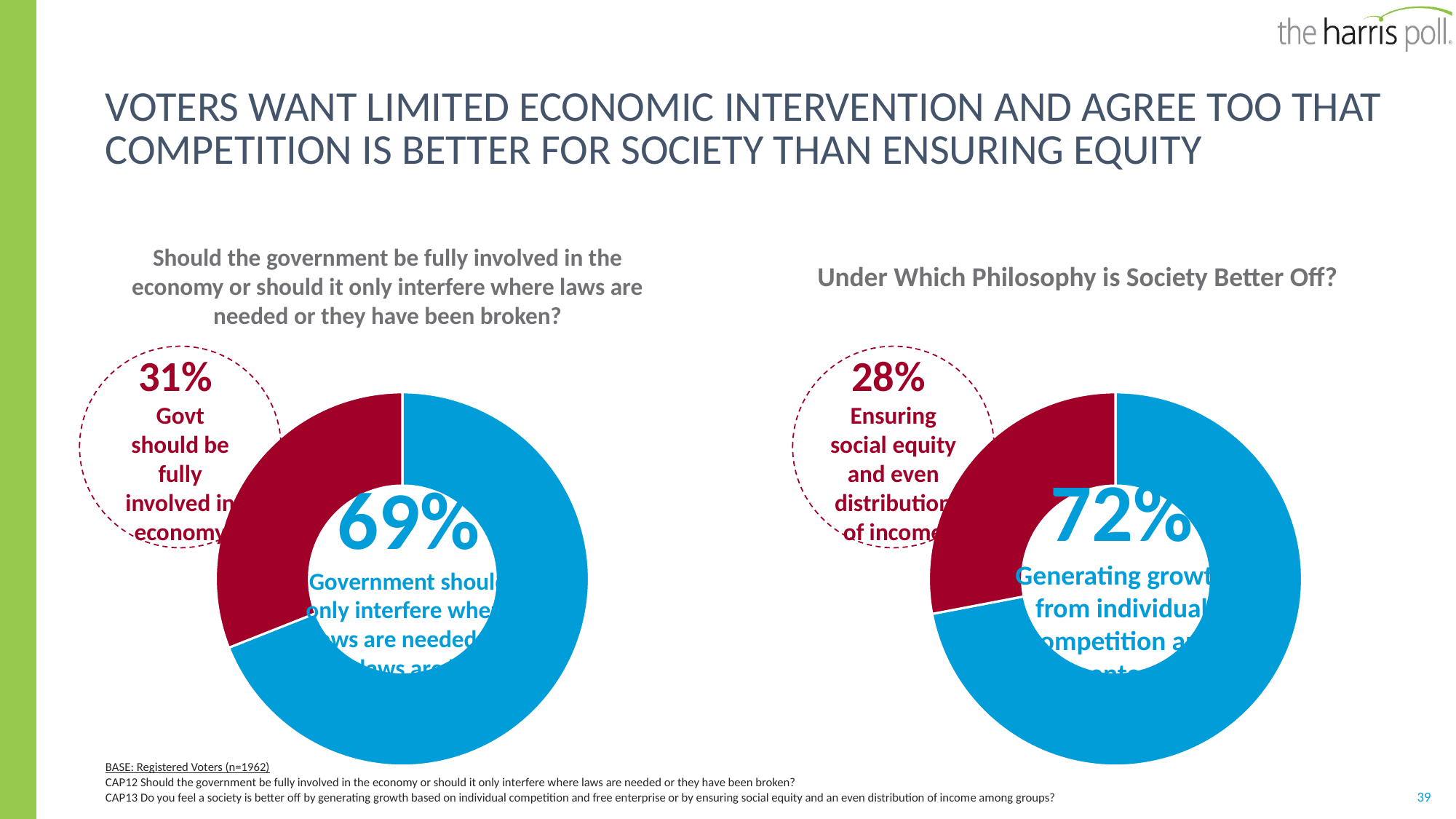
How many slices does the right chart (Under Which Philosophy is Society Better Off?) have? 2 In the left chart (government involvement in the economy), what is the difference in percentage points between the two responses? 38 In the left chart (government involvement in the economy), what colour is the slice for government should be fully involved in the economy? Red What type of chart is used on this slide? Donut (pie) chart Which is larger: the 31% for government fully involved in the left chart, or the 28% for ensuring social equity in the right chart? 31% for government fully involved In the left chart (government involvement in the economy), which response has the larger share? Government should only interfere where laws are needed In the right chart (Under Which Philosophy is Society Better Off?), what percentage choose generating growth from individual competition? 72% In the right chart (Under Which Philosophy is Society Better Off?), what is the difference in percentage points between the two responses? 44 In the right chart (Under Which Philosophy is Society Better Off?), what percentage choose ensuring social equity and even distribution of income? 28% In the right chart (Under Which Philosophy is Society Better Off?), which response has the smaller share? Ensuring social equity and even distribution of income In the left chart (government involvement in the economy), what percentage say the government should only interfere where laws are needed or have been broken? 69% In the left chart (government involvement in the economy), what percentage say the government should be fully involved in the economy? 31%